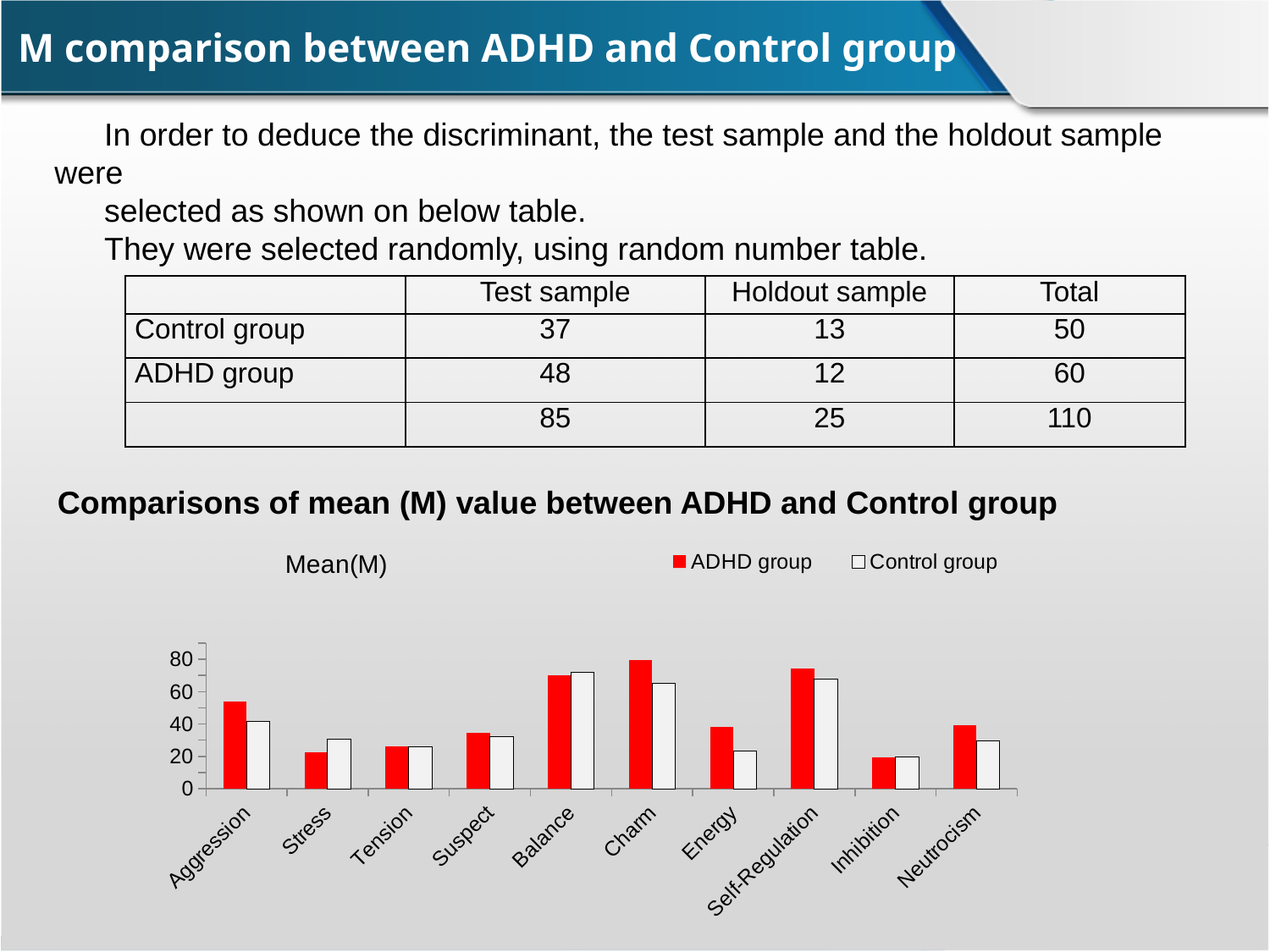
For Stress, which is larger: the ADHD group or the Control group? Control group What kind of chart is shown on the slide? bar chart For Energy, which is larger: the ADHD group or the Control group? ADHD group Is the ADHD group value for Charm greater or less than 60? greater How many categories are shown on the x axis of the chart? 10 For Aggression, which is larger: the ADHD group or the Control group? ADHD group How many series does the chart's legend list? 2 Is the Control group value for Balance greater or less than 60? greater Which category has the lowest value for the ADHD group? Inhibition Which category has the highest value for the ADHD group? Charm What is the title shown on the chart? Mean(M) Is the ADHD group value for Stress greater or less than 40? less